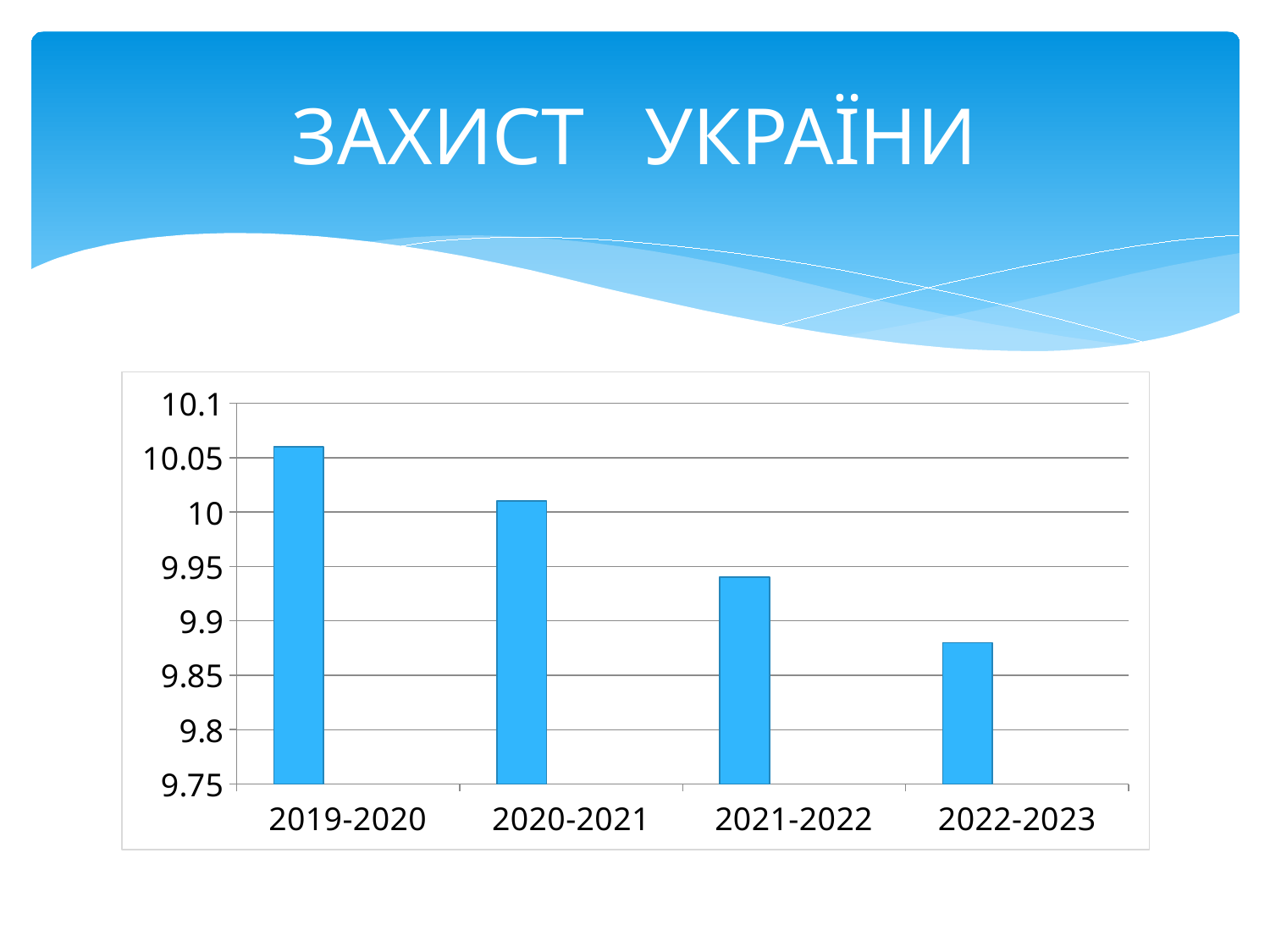
Is the value for 2021-2022 greater or less than 10? less What kind of chart is shown on the slide? bar chart Which is larger, the value for 2020-2021 or the value for 2021-2022? 2020-2021 Is the value for 2022-2023 greater or less than 9.9? less How many categories are shown on the x axis of the chart? 4 Is the value for 2019-2020 greater or less than 10? greater What is the title of the slide containing the chart? ЗАХИСТ УКРАЇНИ Which category has the highest value in the chart? 2019-2020 Which category has the lowest value in the chart? 2022-2023 Do the values rise or fall from 2019-2020 to 2022-2023? fall